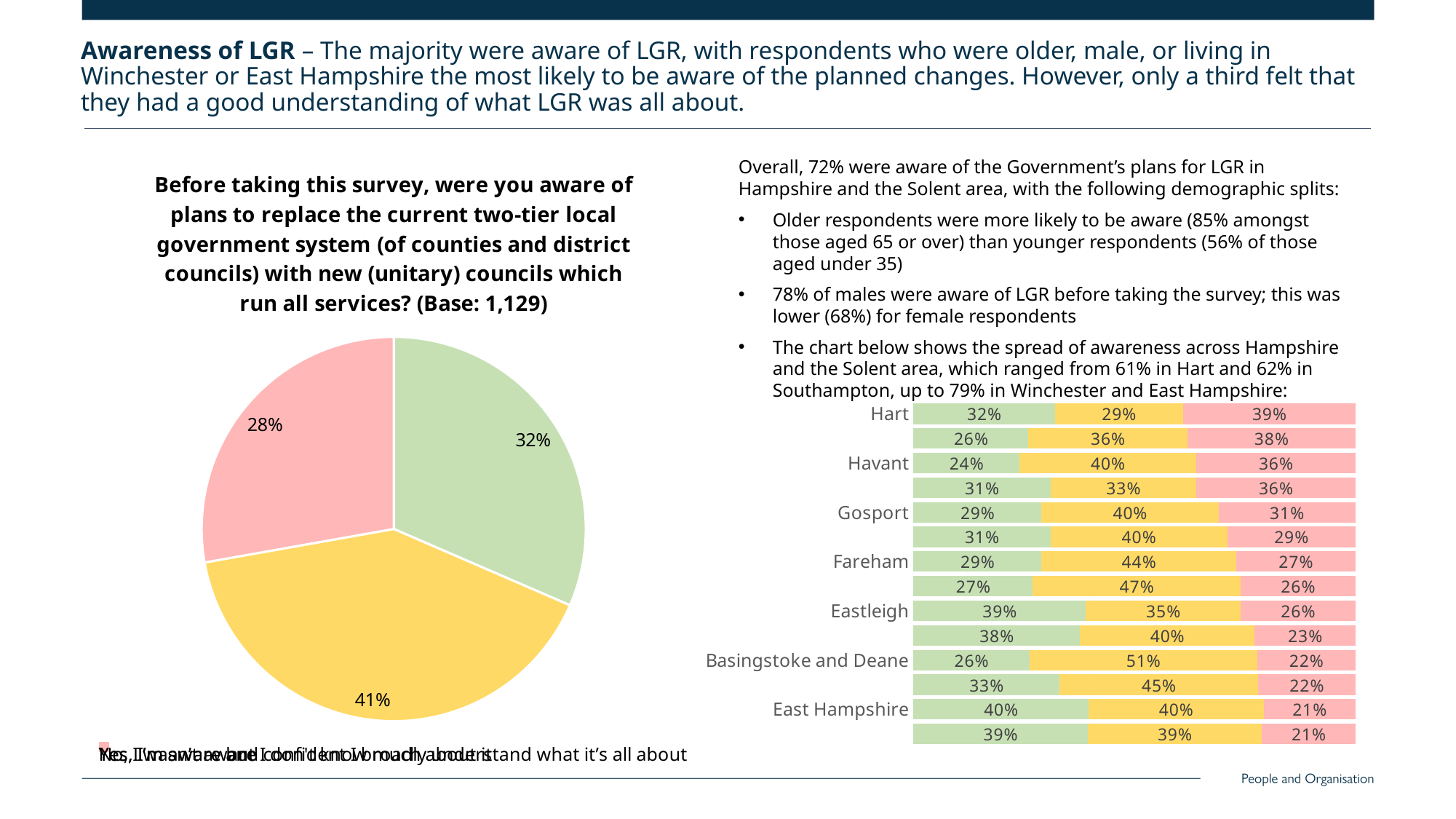
In the bar chart on the right, which has the larger yellow value, Fareham or Eastleigh? Fareham What kind of chart is shown on the right of the slide? Bar chart In the pie chart on the left, what percentage does the yellow slice show? 41% In the pie chart on the left, which slice is the largest? The yellow slice (41%) How many slices does the pie chart on the left have? 3 In the bar chart on the right, what is the pink value for East Hampshire? 21% In the bar chart on the right, what is the difference between the yellow and pink values for Basingstoke and Deane? 29 percentage points In the bar chart on the right, what is the yellow value for Basingstoke and Deane? 51% In the pie chart on the left, what percentage does the pink slice show? 28% What kind of chart is shown on the left of the slide? Pie chart In the pie chart on the left, what is the difference between the green slice and the pink slice? 4 percentage points In the bar chart on the right, what is the green value for Hart? 32%